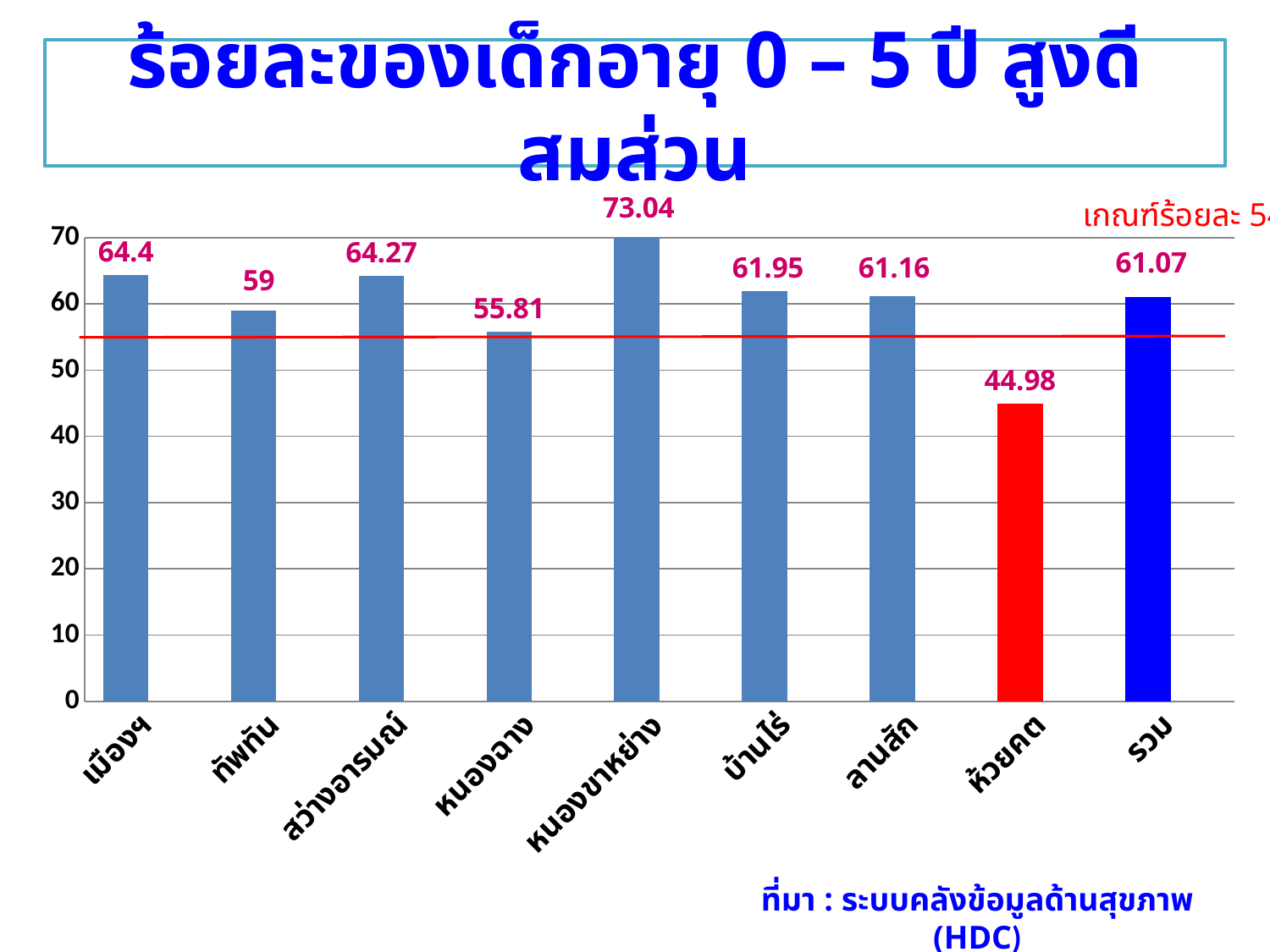
Is the value for ห้วยคต greater or less than 50? less Which is larger, the value for เมืองฯ or the value for หนองฉาง? เมืองฯ What kind of chart is shown on the slide? bar chart What is the value for รวม? 61.07 What is the difference between the values for หนองขาหย่าง and ห้วยคต? 28.06 Which bar is coloured red? ห้วยคต What is the value for ทัพทัน? 59 Which category has the lowest value? ห้วยคต How many categories are shown on the x axis? 9 Which category has the highest value? หนองขาหย่าง What is the value for ห้วยคต? 44.98 What is the value for หนองขาหย่าง? 73.04